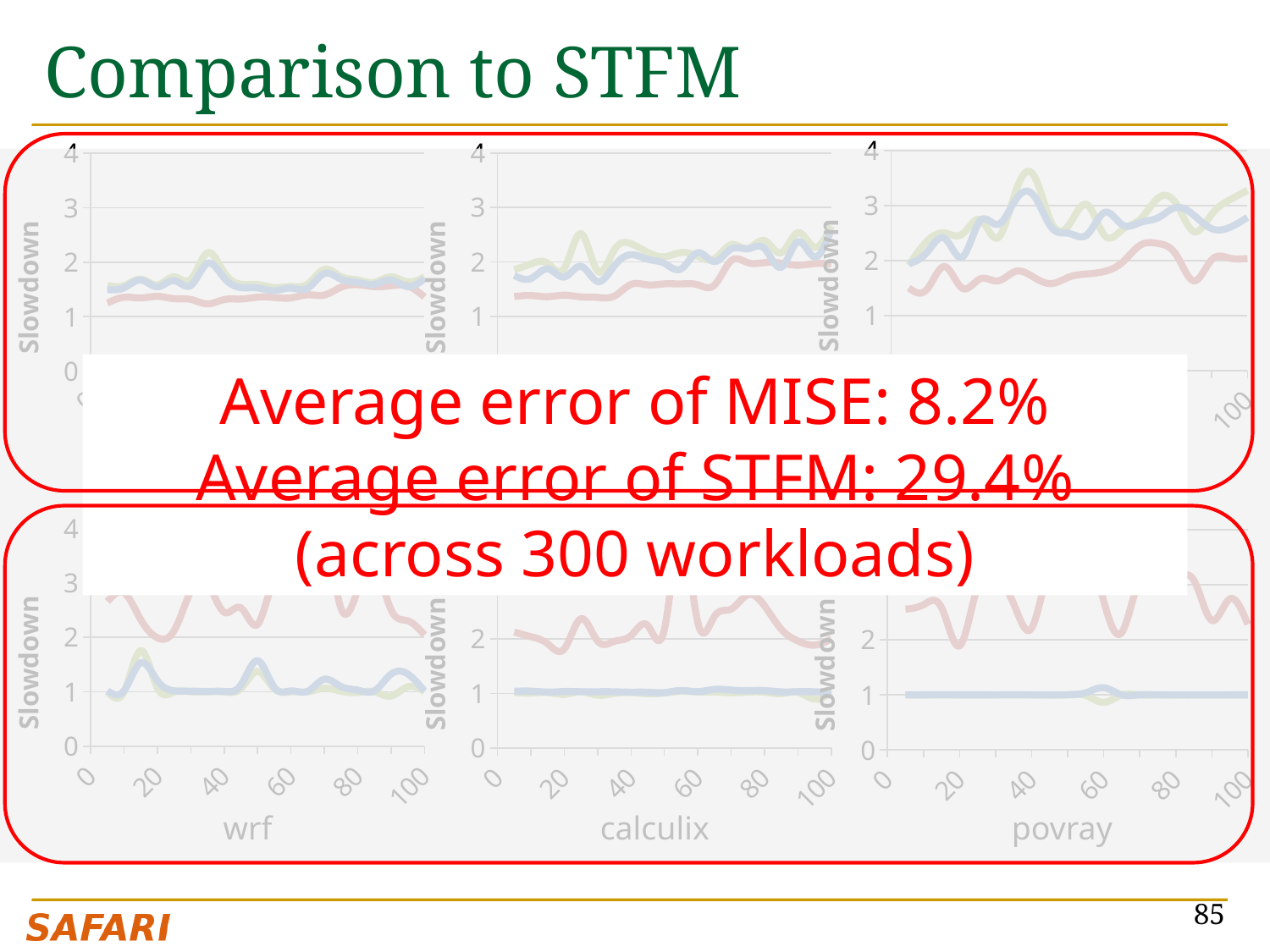
In the top-right chart, does the blue line generally rise or fall from x = 0 to x = 40? rise In the top-right chart, is the red line's value at x = 40 greater or less than 3? less What is the x-axis category label under the bottom-middle chart? calculix In the top-left chart, is the blue line's value at x = 60 greater or less than 3? less In the bottom-right chart labelled povray, is the blue line's value at x = 40 greater or less than 2? less In the top-middle chart, does the red line generally rise or fall from x = 0 to x = 100? rise How many charts are shown on the slide? 6 What kind of chart is used in the bottom-left chart labelled wrf? line chart What is the highest tick value shown on the y-axis of the bottom-right chart labelled povray? 4 What is the y-axis label on the bottom-left chart labelled wrf? Slowdown In the bottom-middle chart labelled calculix, which line is higher at x = 60, the red line or the blue line? red line